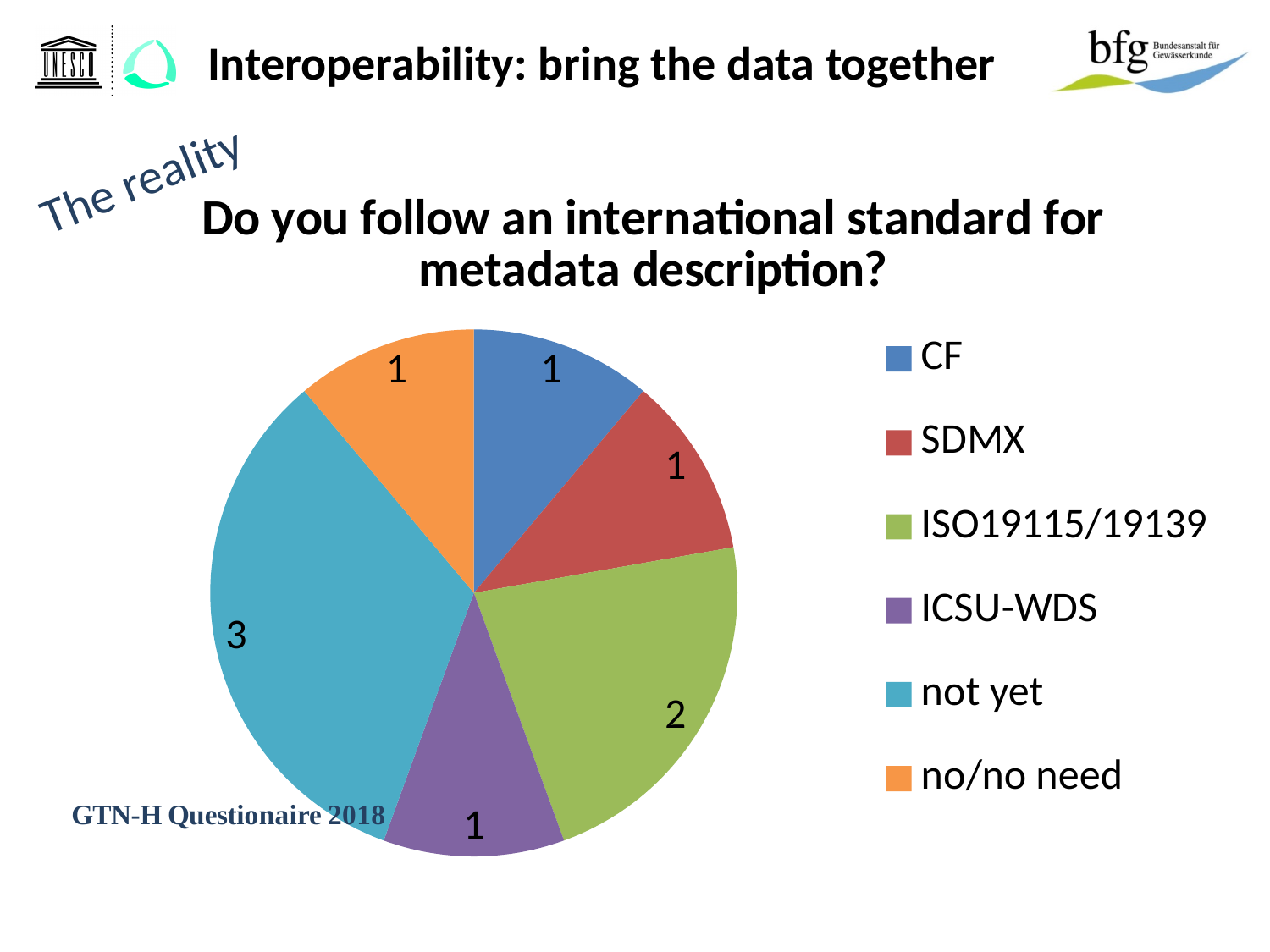
How many categories does the pie chart have? 6 What is the title of the chart? Do you follow an international standard for metadata description? What is the value for the ISO19115/19139 slice? 2 What is the total of all the slice values in the pie chart? 9 What is the value for the 'not yet' slice? 3 What type of chart is shown on the slide? pie chart What colour is the ICSU-WDS slice? purple Which is larger, the value for ISO19115/19139 or the value for SDMX? ISO19115/19139 What is the value for the CF slice? 1 What is the difference between the 'not yet' value and the ISO19115/19139 value? 1 Which category has the largest slice of the pie? not yet What is the value for the 'no/no need' slice? 1